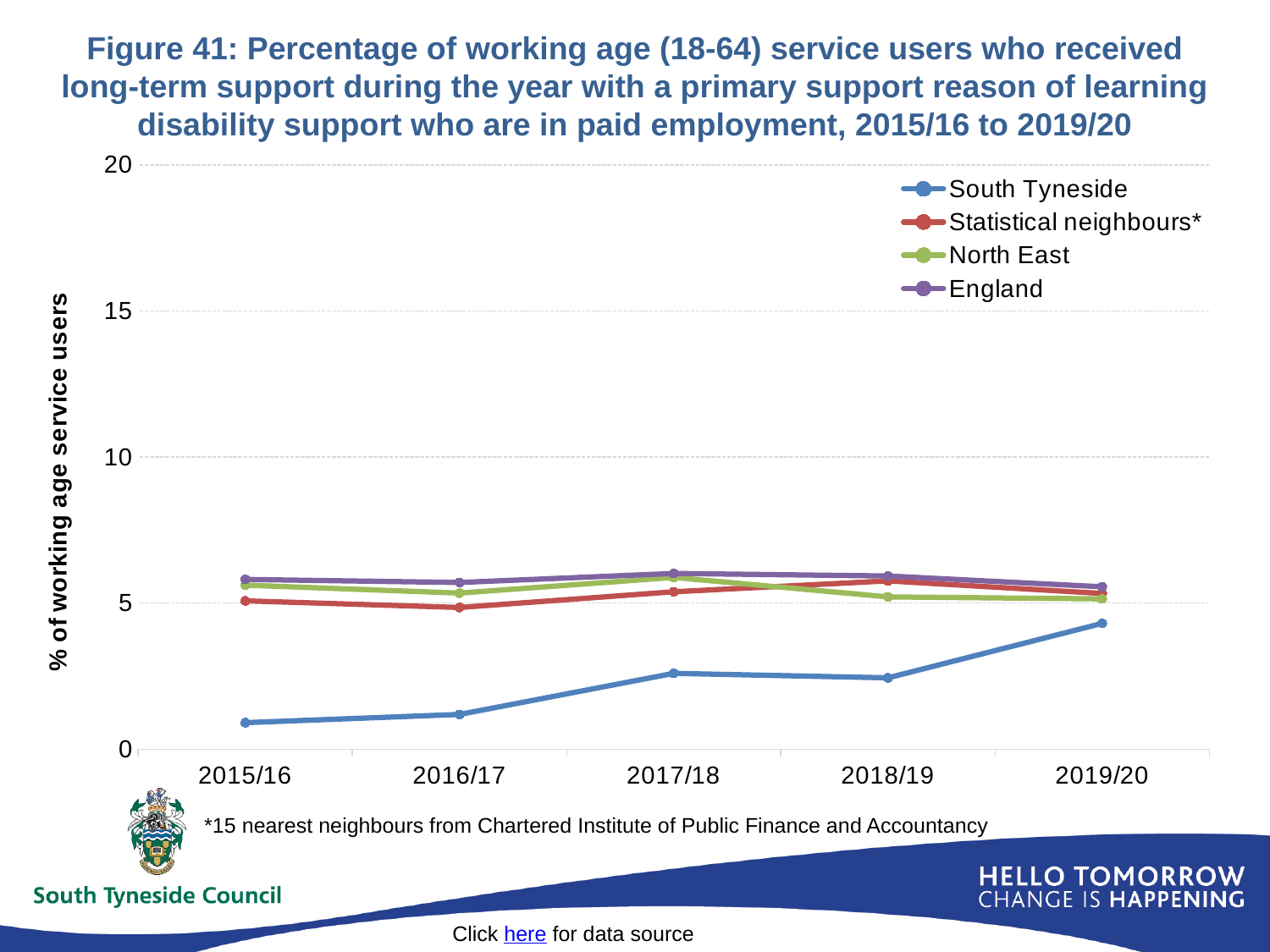
What kind of chart is shown on the slide? line chart Which series is shown in blue in the legend? South Tyneside How many years are plotted along the x axis? 5 Does the South Tyneside line rise or fall from 2015/16 to 2019/20? rise Is the value for England in 2015/16 greater or less than 5? greater Is the value for South Tyneside in 2019/20 greater or less than 5? less How many series does the legend list? 4 Is the value for Statistical neighbours* in 2018/19 greater or less than 10? less In 2016/17, which is larger: the value for South Tyneside or the value for North East? North East Which series has the lowest value in 2019/20? South Tyneside What is the label on the y axis? % of working age service users